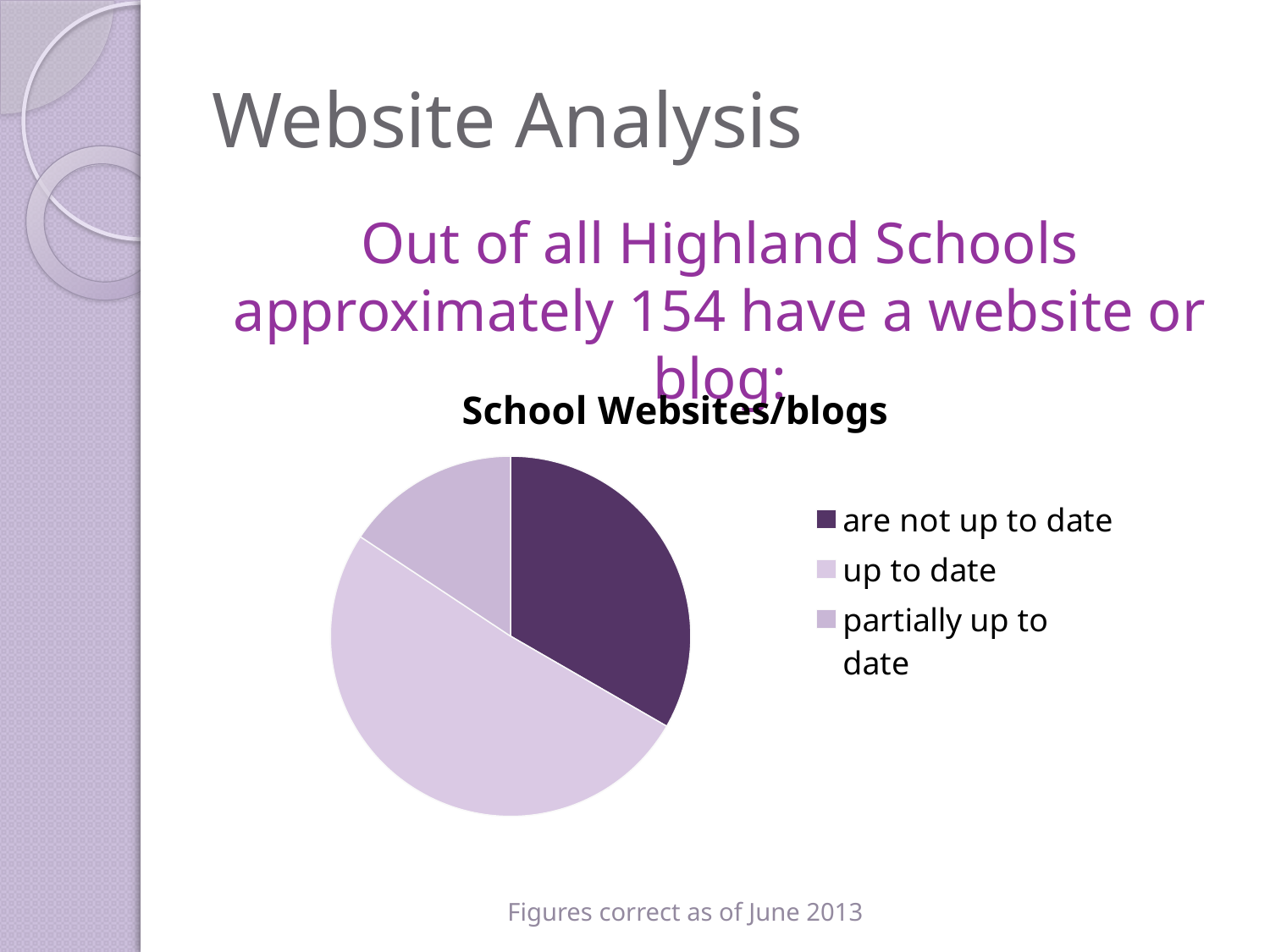
What is the title of the chart? School Websites/blogs Which slice is larger: "up to date" or "are not up to date"? up to date How many entries does the chart's legend list? 3 Which legend entry is shown in the darkest purple colour? are not up to date Which category has the smallest slice of the pie? partially up to date What kind of chart is shown on the slide? pie chart Which slice is larger: "are not up to date" or "partially up to date"? are not up to date How many slices does the pie chart have? 3 Which category has the largest slice of the pie? up to date